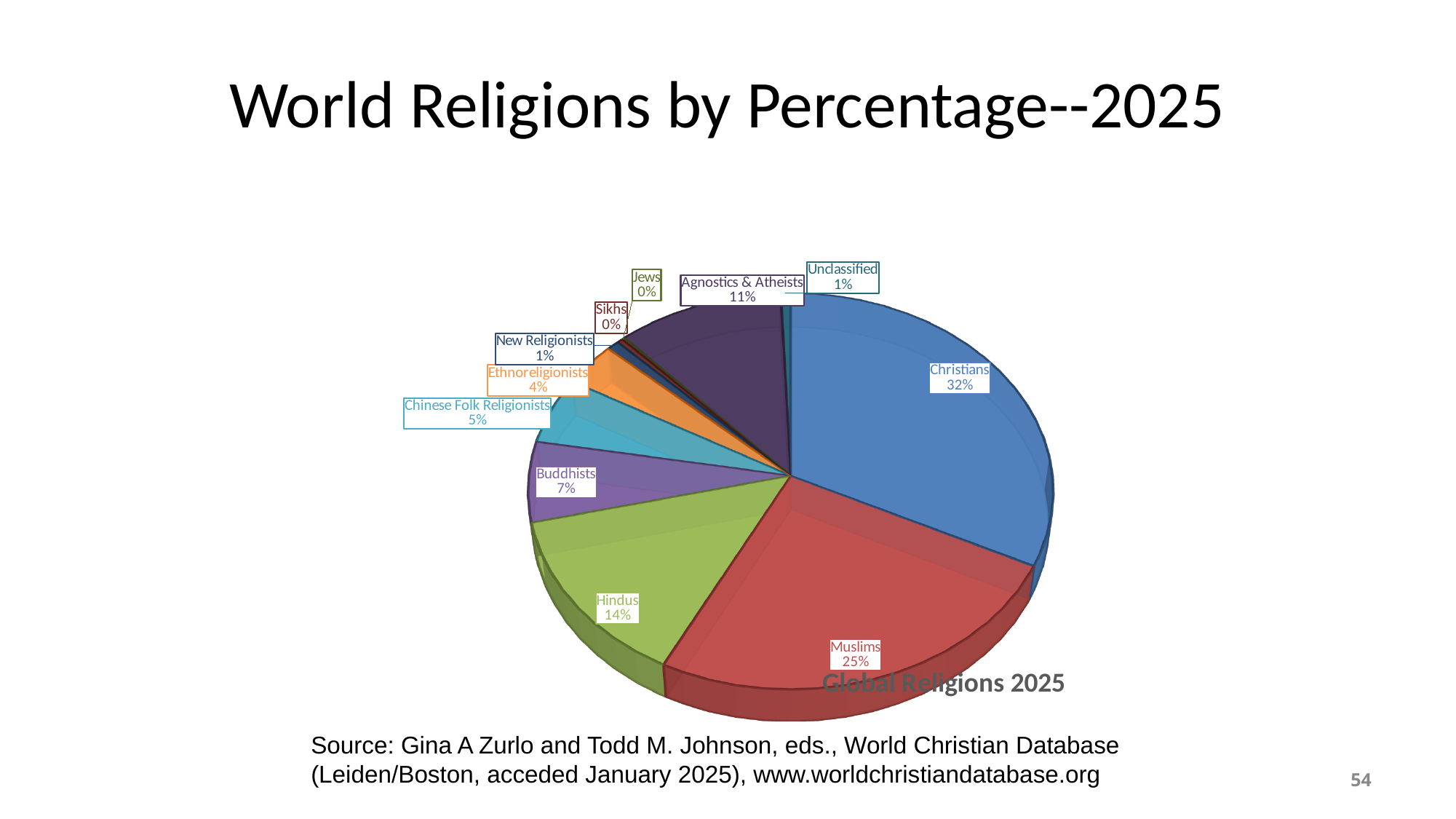
What percentage is shown for Hindus? 14% What percentage of the pie is labelled for Christians? 32% What is the combined percentage of Hindus and Buddhists? 21% What percentage is shown for Agnostics & Atheists? 11% What is the difference in percentage points between Christians and Muslims? 7 Which slice is larger, Buddhists or Ethnoreligionists? Buddhists What percentage is shown for Muslims? 25% How many categories are labelled on the pie chart? 11 What percentage is shown for Chinese Folk Religionists? 5% What is the title printed on the chart itself? Global Religions 2025 Which group has the largest slice of the pie? Christians What kind of chart is shown on the slide? Pie chart